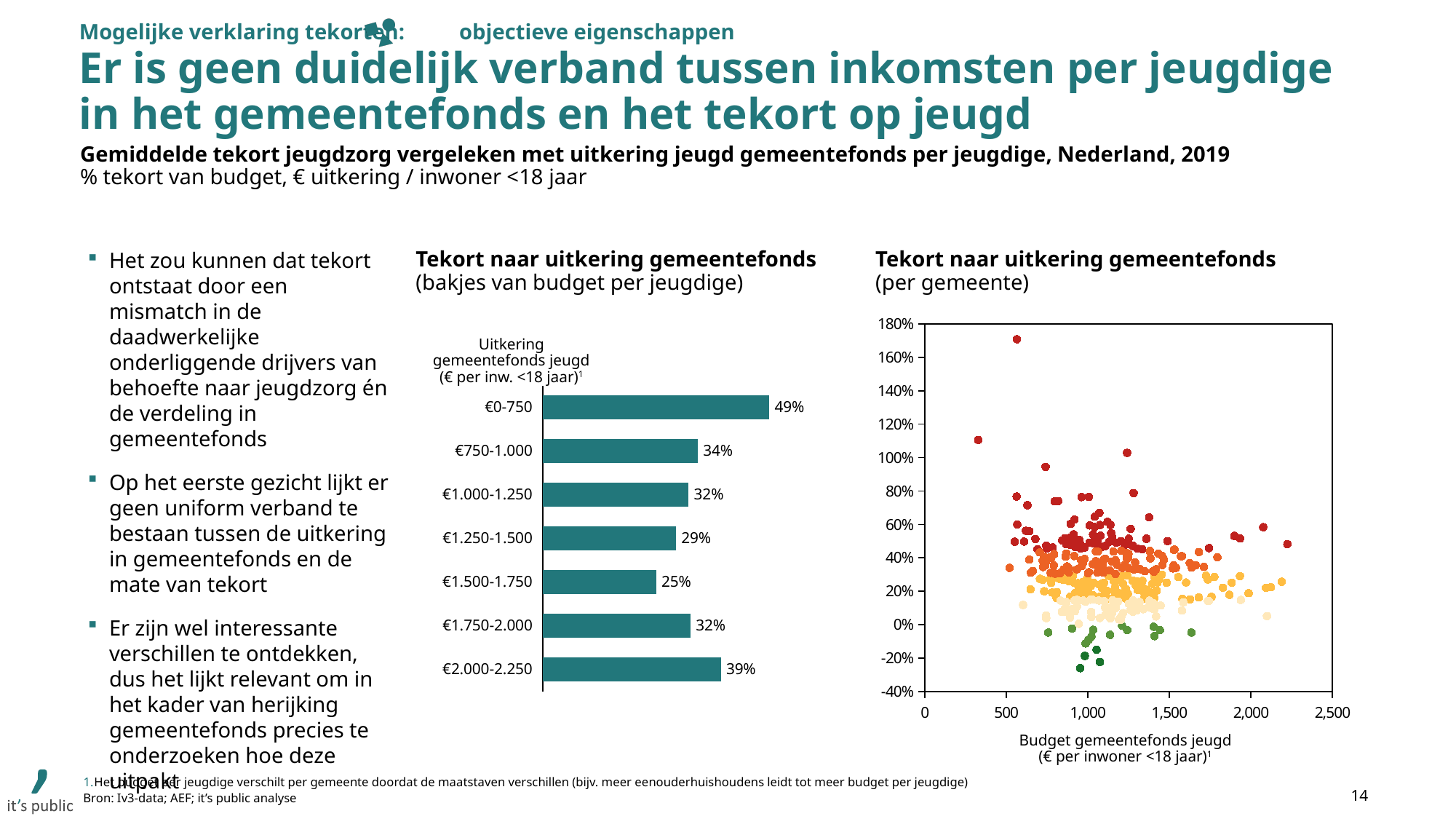
In the bar chart 'Tekort naar uitkering gemeentefonds (bakjes van budget per jeugdige)', what is the difference between the €0-750 and €750-1.000 values? 15 percentage points In the scatter chart 'Tekort naar uitkering gemeentefonds (per gemeente)', what is the label of the x axis? Budget gemeentefonds jeugd (€ per inwoner <18 jaar) In the scatter chart 'Tekort naar uitkering gemeentefonds (per gemeente)', is the highest plotted point greater or less than 160%? greater In the bar chart 'Tekort naar uitkering gemeentefonds (bakjes van budget per jeugdige)', what is the value for the €1.500-1.750 category? 25% What kind of chart is the left chart 'Tekort naar uitkering gemeentefonds (bakjes van budget per jeugdige)'? Bar chart In the bar chart 'Tekort naar uitkering gemeentefonds (bakjes van budget per jeugdige)', what is the value for the €2.000-2.250 category? 39% How many categories does the bar chart 'Tekort naar uitkering gemeentefonds (bakjes van budget per jeugdige)' show? 7 In the bar chart 'Tekort naar uitkering gemeentefonds (bakjes van budget per jeugdige)', which is larger: the value for €1.250-1.500 or for €2.000-2.250? €2.000-2.250 In the bar chart 'Tekort naar uitkering gemeentefonds (bakjes van budget per jeugdige)', which category has the highest value? €0-750 What kind of chart is the right chart 'Tekort naar uitkering gemeentefonds (per gemeente)'? Scatter plot In the bar chart 'Tekort naar uitkering gemeentefonds (bakjes van budget per jeugdige)', what is the value for the €0-750 category? 49% In the bar chart 'Tekort naar uitkering gemeentefonds (bakjes van budget per jeugdige)', which category has the lowest value? €1.500-1.750